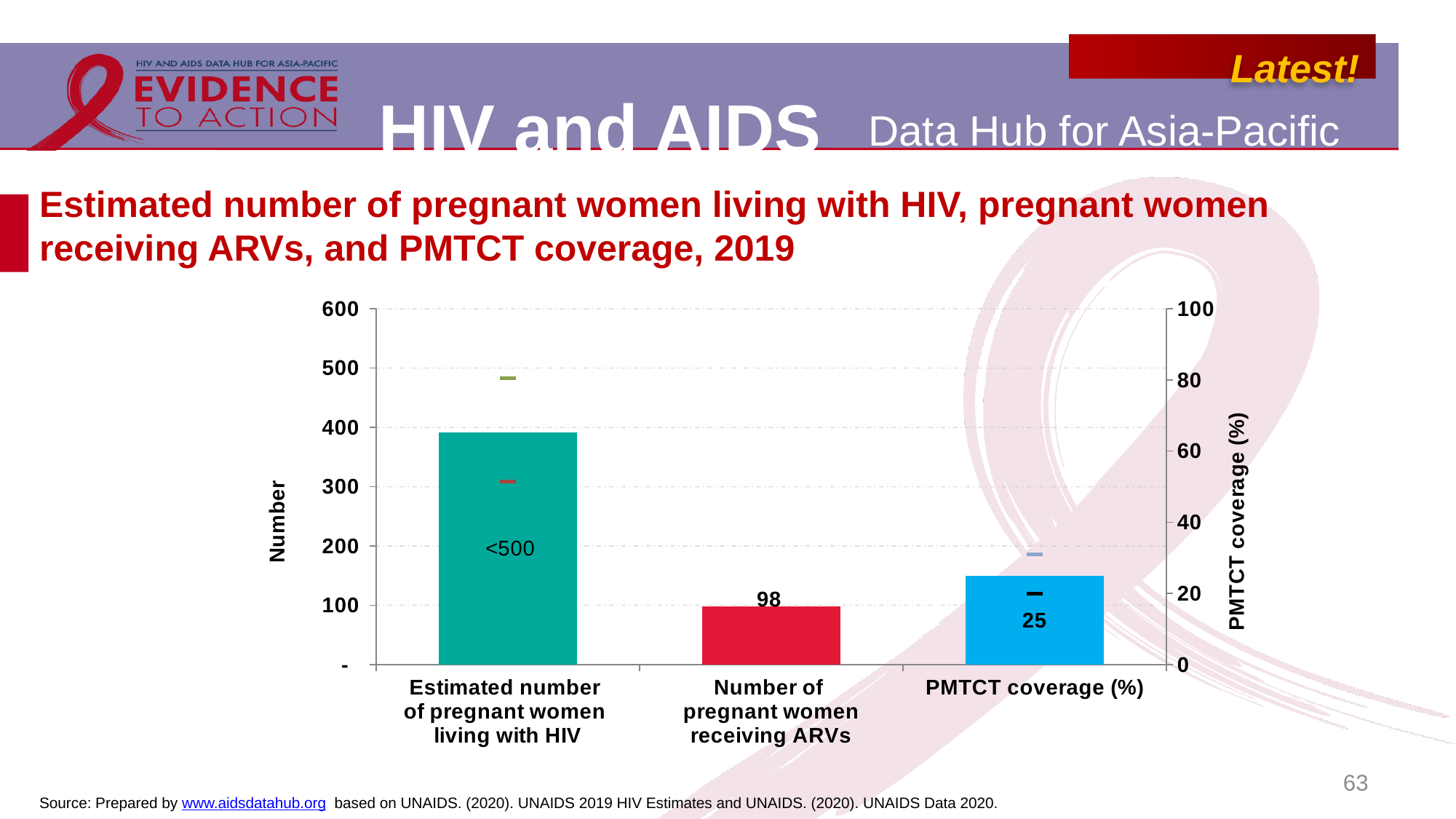
What is the title of the left vertical axis? Number Is the bar for Estimated number of pregnant women living with HIV greater or less than 300 on the Number axis? greater What is the maximum value shown on the right vertical axis? 100 Which category has the shortest bar on the chart? Number of pregnant women receiving ARVs What label is printed on the bar for Estimated number of pregnant women living with HIV? <500 How many bars are plotted on the chart? 3 What is the title of the right vertical axis? PMTCT coverage (%) Which category has the tallest bar on the chart? Estimated number of pregnant women living with HIV What is the data label shown on the bar for Number of pregnant women receiving ARVs? 98 What type of chart is shown on the slide? Bar chart Is the bar for Number of pregnant women receiving ARVs greater or less than 200 on the Number axis? less What is the PMTCT coverage (%) value shown on the chart? 25